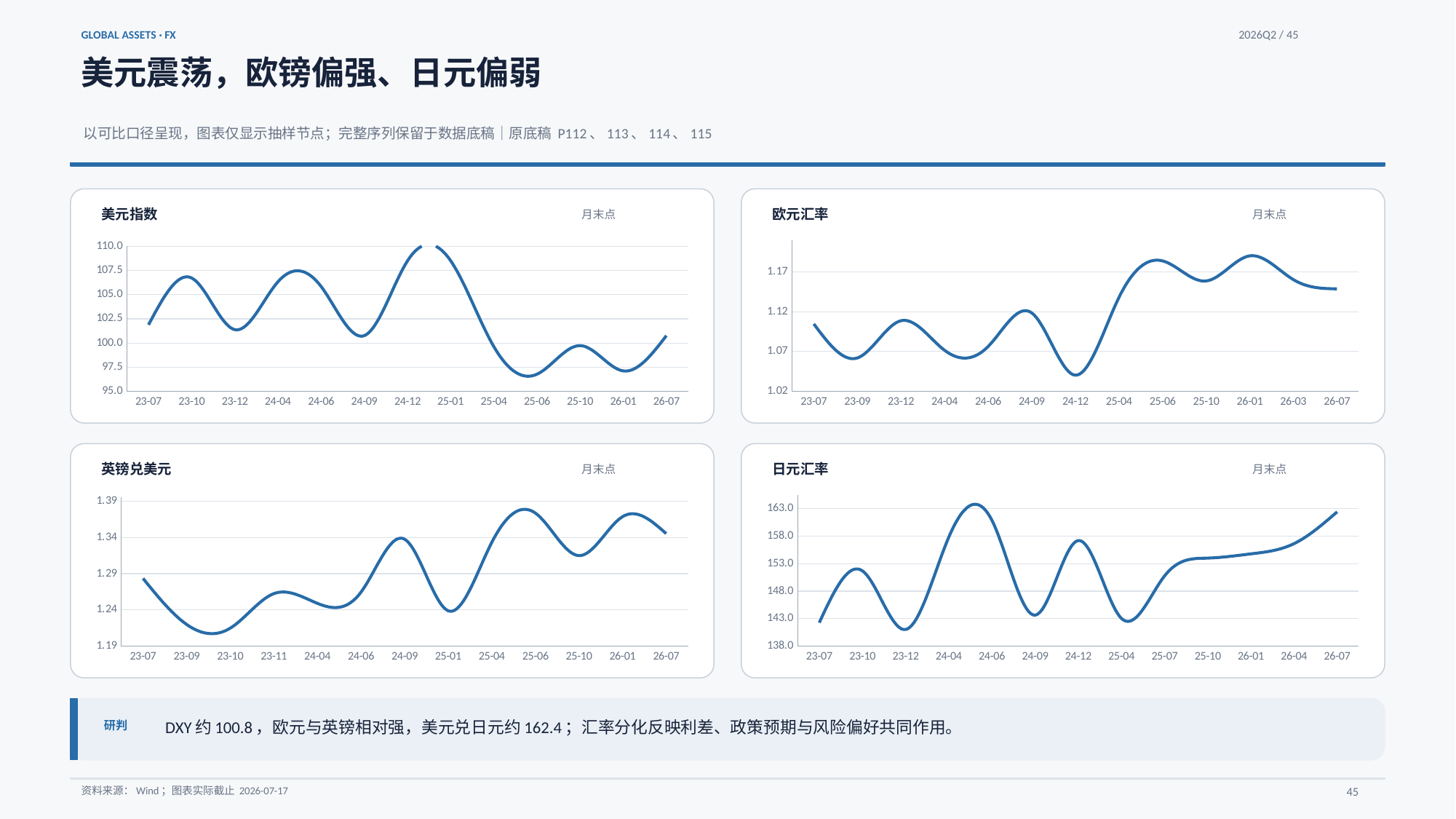
What label appears in the top-right corner of each chart panel? 月末点 In the 欧元汇率 chart, which time point has the lowest value? 24-12 How many time points are shown on the x axis of the 欧元汇率 chart? 13 In the 美元指数 chart, is the value at 23-10 greater or less than 105.0? greater In the 美元指数 chart, which is larger, the value at 23-07 or the value at 24-04? 24-04 In the 日元汇率 chart, do values rise or fall from 25-04 to 26-07? rise In the 日元汇率 chart, is the value at 23-12 greater or less than 143.0? less In the 英镑兑美元 chart, which time point has the lowest value? 23-10 In the 欧元汇率 chart, is the value at 24-12 greater or less than 1.07? less What kind of chart is the 美元指数 chart? line chart